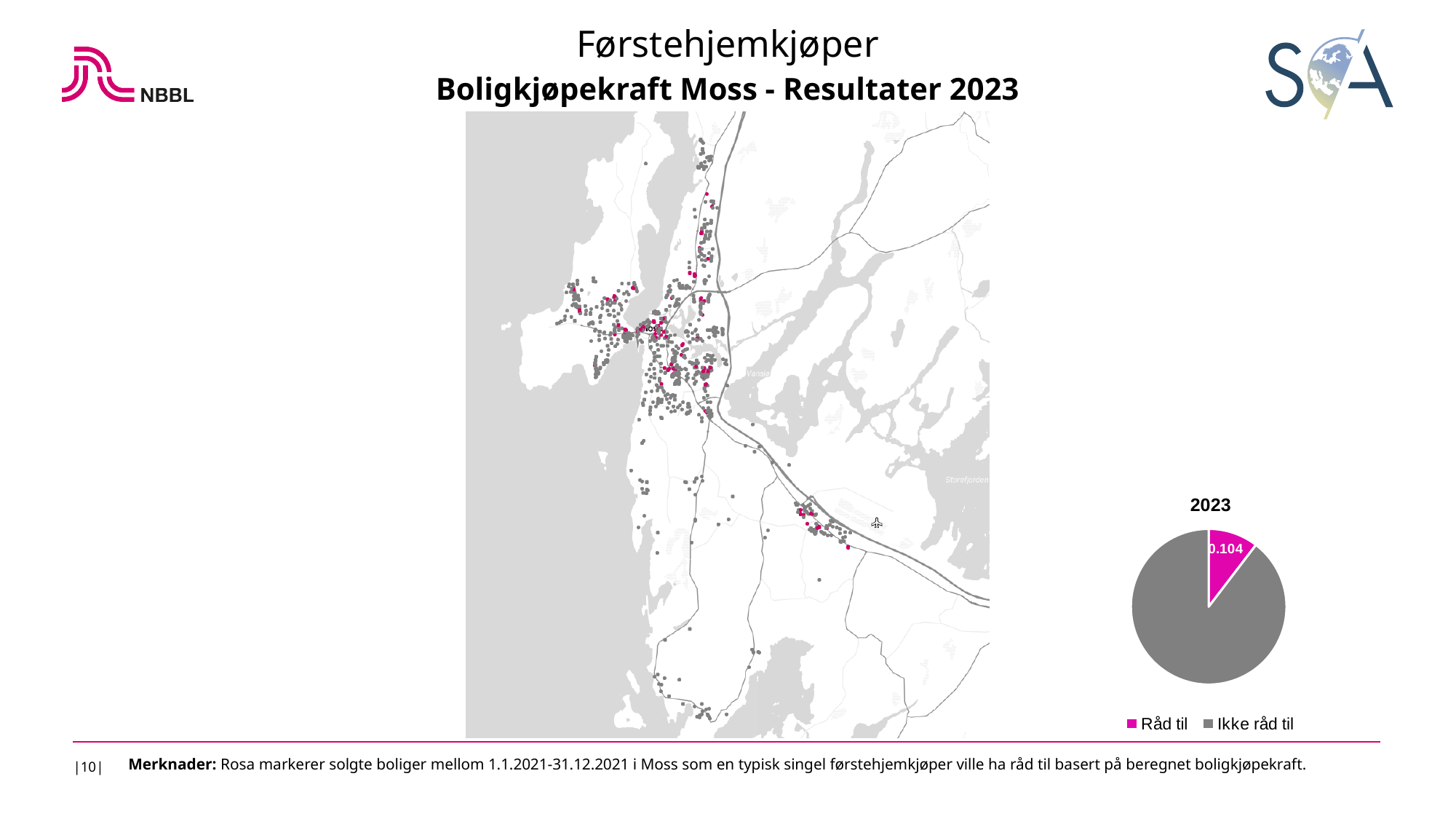
How many categories does the pie chart's legend list? 2 In the pie chart, which category has the largest slice? Ikke råd til In the pie chart, which category has the smallest slice? Råd til In the pie chart, which is larger: 'Råd til' or 'Ikke råd til'? Ikke råd til What kind of chart is shown on the right side of the slide? pie chart In the pie chart, what value is labelled on the 'Råd til' slice? 0.104 What colour is the 'Råd til' slice in the pie chart? pink What is the title of the pie chart? 2023 How many slices does the pie chart have? 2